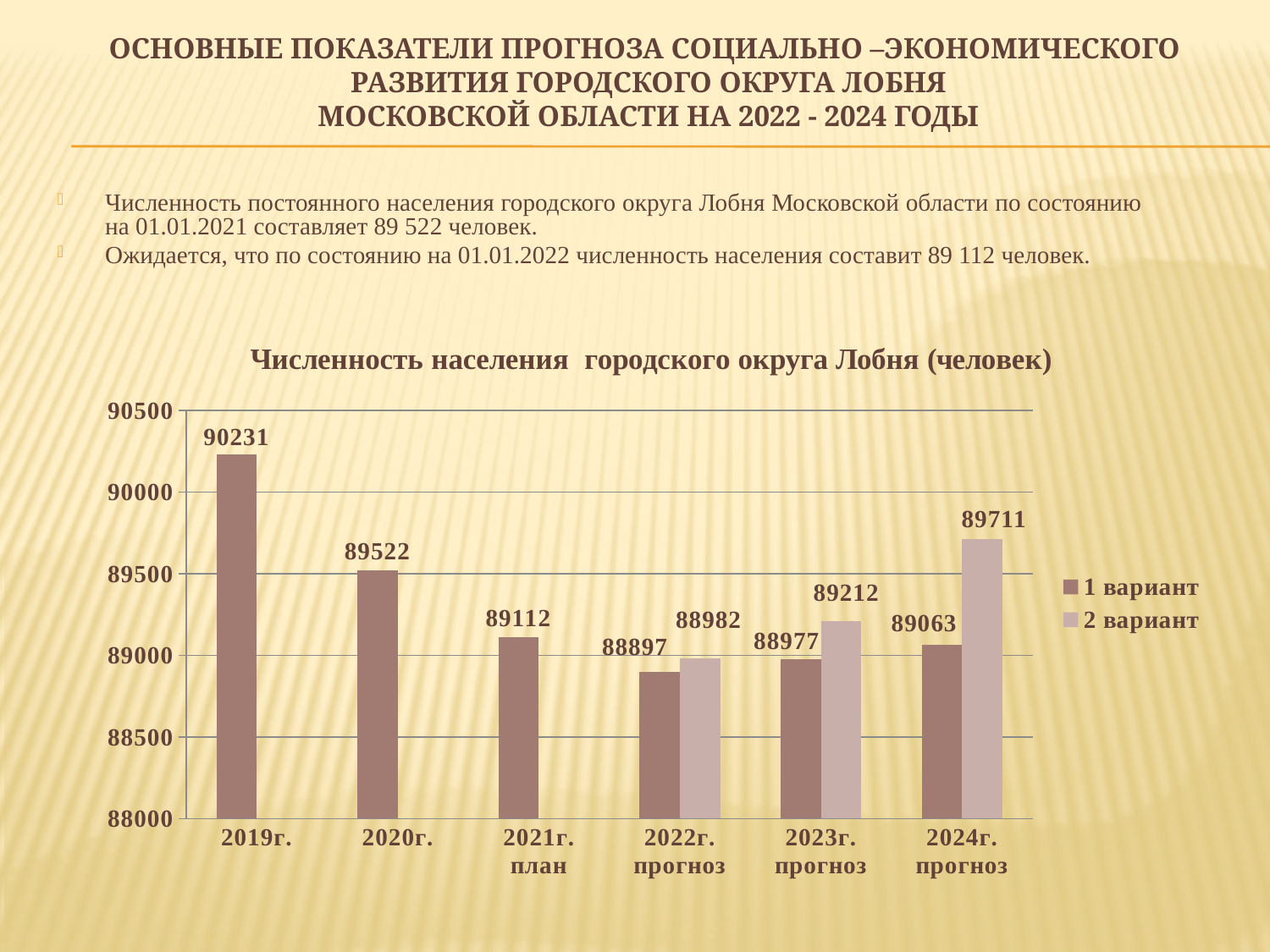
How many series does the legend list? 2 Is the value for 1 вариант in 2020г. greater or less than 89500? greater What is the value for 2 вариант in 2024г. прогноз? 89711 What is the value for 1 вариант in 2022г. прогноз? 88897 Which category has the highest value for 1 вариант? 2019г. Which is larger in 2023г. прогноз: 1 вариант or 2 вариант? 2 вариант What kind of chart is shown on the slide? bar chart What is the difference between 2 вариант and 1 вариант in 2024г. прогноз? 648 Which category has the lowest value for 1 вариант? 2022г. прогноз How many categories are shown on the x axis? 6 Does the value for 1 вариант rise or fall from 2019г. to 2022г. прогноз? fall What is the value for 1 вариант in 2019г.? 90231